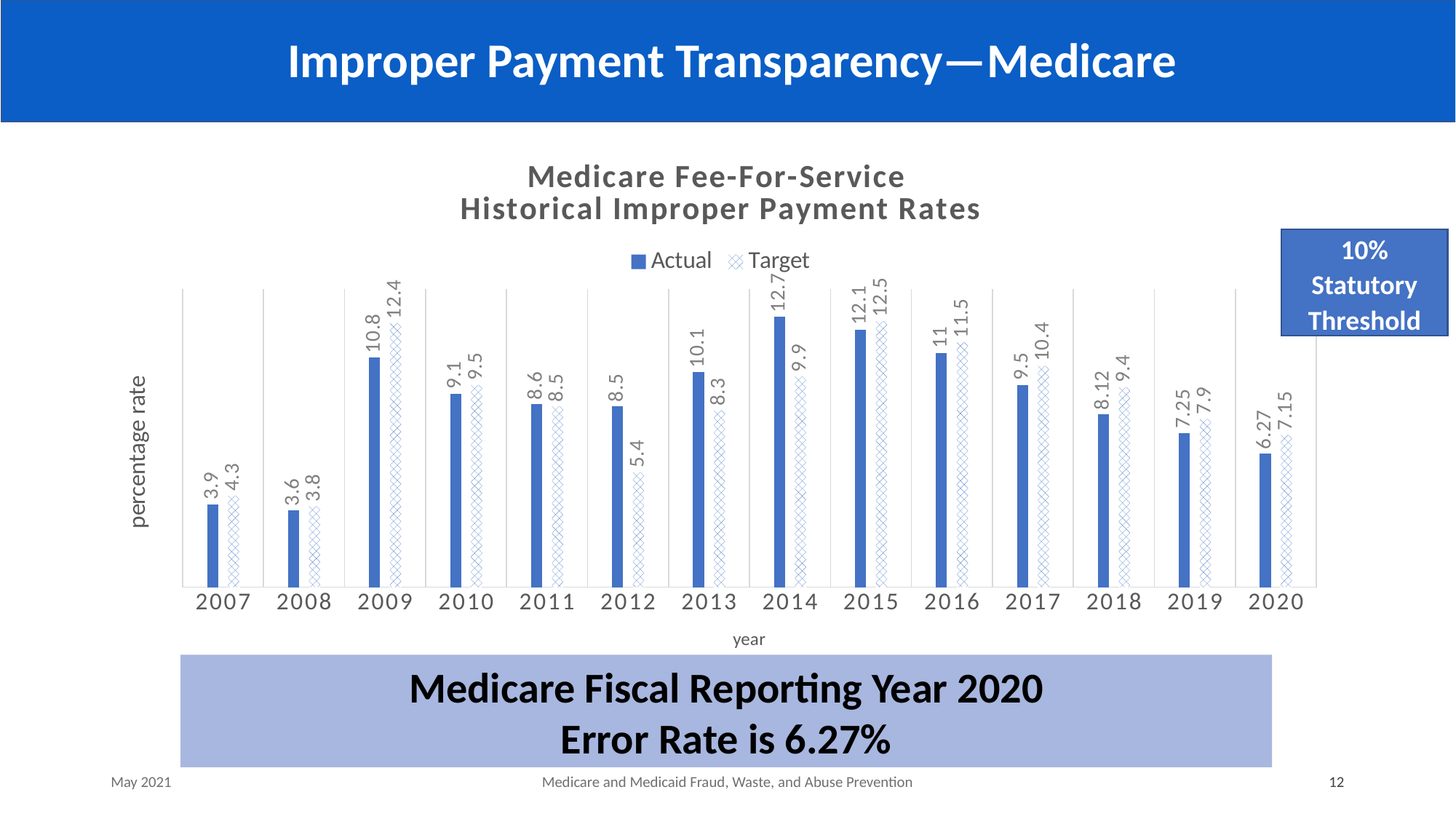
How many years are shown on the x axis? 14 What is the Actual improper payment rate for 2020? 6.27 What is the Target improper payment rate for 2012? 5.4 Which is larger for 2012, the Actual rate or the Target rate? Actual What kind of chart is shown on the slide? Bar chart Does the Actual improper payment rate rise or fall from 2014 to 2020? Fall What is the title of the chart? Medicare Fee-For-Service Historical Improper Payment Rates How many series does the legend list? 2 Which year has the lowest Actual improper payment rate? 2008 What is the difference between the Target and Actual rates for 2009? 1.6 Which year has the highest Actual improper payment rate? 2014 What is the Actual improper payment rate for 2014? 12.7